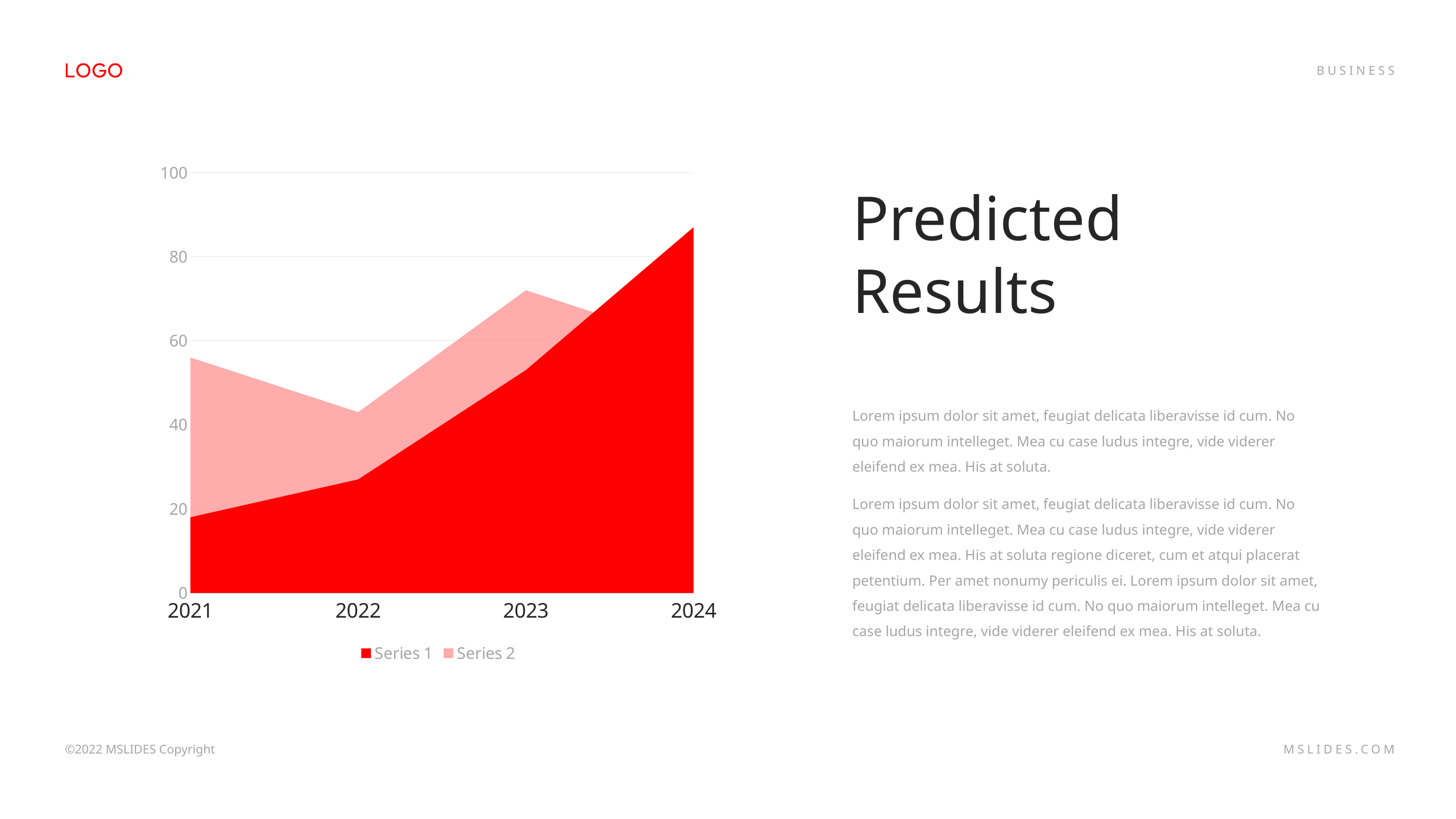
In which year is Series 1 highest? 2024 Does Series 1 rise or fall from 2021 to 2024? rise What is the title shown next to the chart on the slide? Predicted Results What kind of chart is shown on the slide? area chart In which year is Series 1 lowest? 2021 Is the value for Series 1 in 2023 greater or less than 60? less How many series does the legend list? 2 Is the value for Series 1 in 2021 greater or less than 20? less In 2021, which is larger, Series 1 or Series 2? Series 2 Is the value for Series 2 in 2023 greater or less than 60? greater How many years are shown on the x axis of the chart? 4